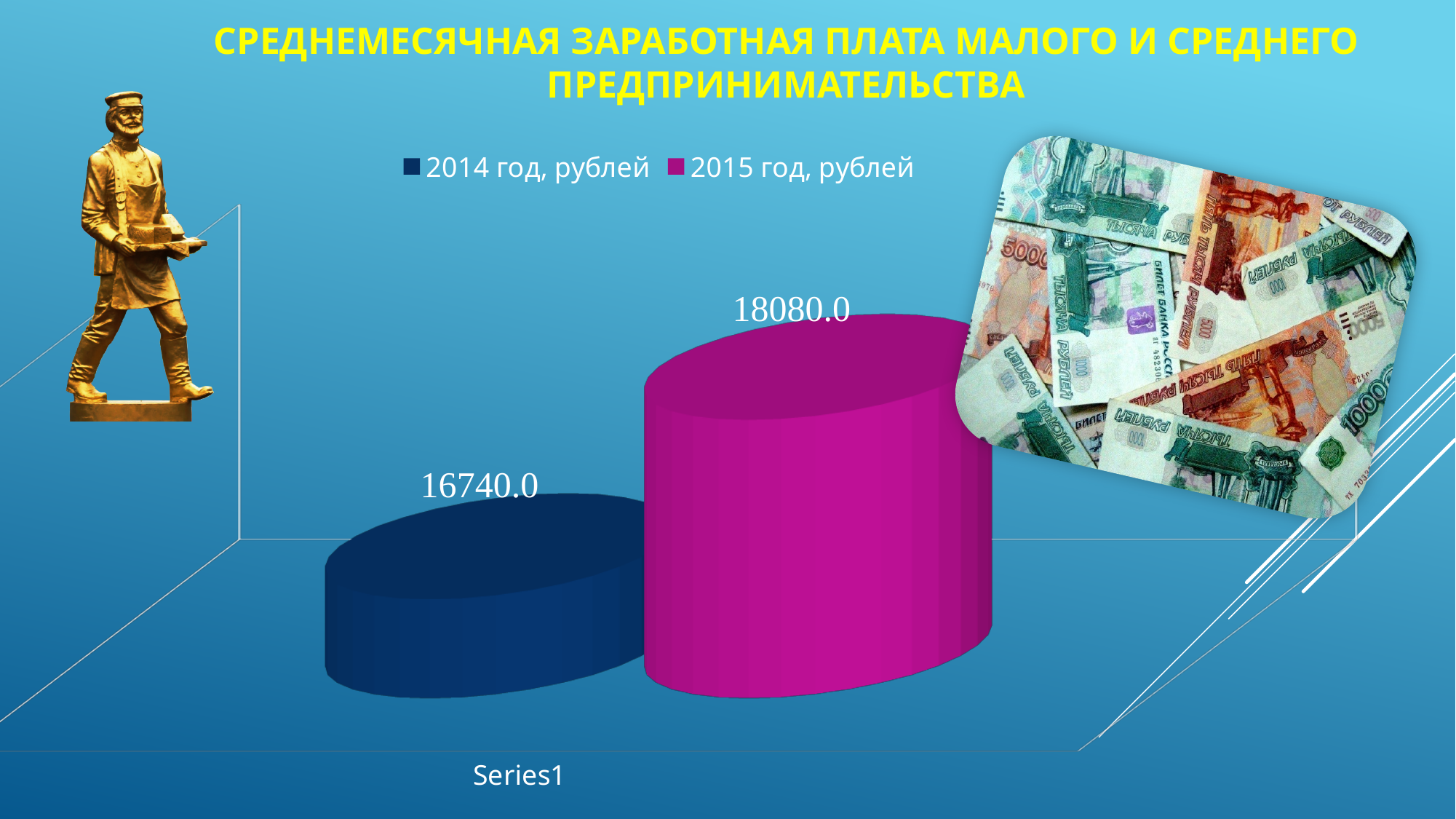
Did the average monthly wage rise or fall from 2014 to 2015? Rise What is the value for the series "2015 год, рублей"? 18080.0 How many categories are shown on the x axis? 1 What kind of chart is shown on the slide? Bar chart What is the value for the series "2014 год, рублей"? 16740.0 What is the difference between the 2015 value and the 2014 value? 1340.0 What is the category label shown on the x axis? Series1 What colour is the bar for "2015 год, рублей"? Magenta How many series does the legend list? 2 Which series has the lowest value? 2014 год, рублей Which series has the highest value? 2015 год, рублей Which series has the higher value, "2014 год, рублей" or "2015 год, рублей"? 2015 год, рублей